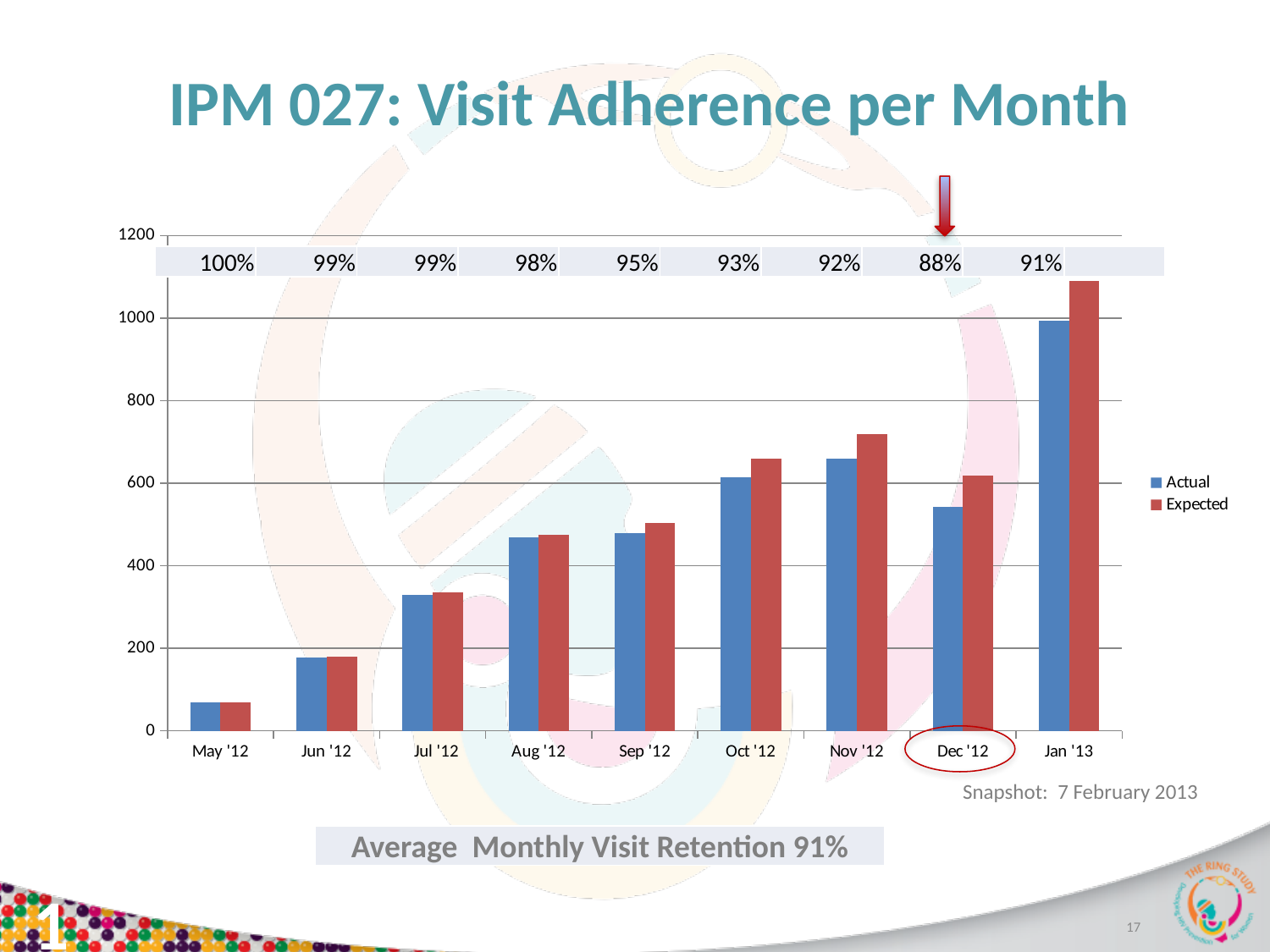
How many months are shown on the x axis? 9 What adherence percentage is shown for May '12? 100% Is the Expected value for Jan '13 greater or less than 1000? greater For Dec '12, which is larger, the Actual or the Expected value? Expected Which month has the lowest adherence percentage printed above the bars? Dec '12 What adherence percentage is shown for Dec '12? 88% What kind of chart is shown on the slide? bar chart How many series does the legend list? 2 Is the Actual value for Dec '12 greater or less than 600? less Which series is shown in red in the legend? Expected Which month has the highest Expected value? Jan '13 Which month has the lowest Actual value? May '12